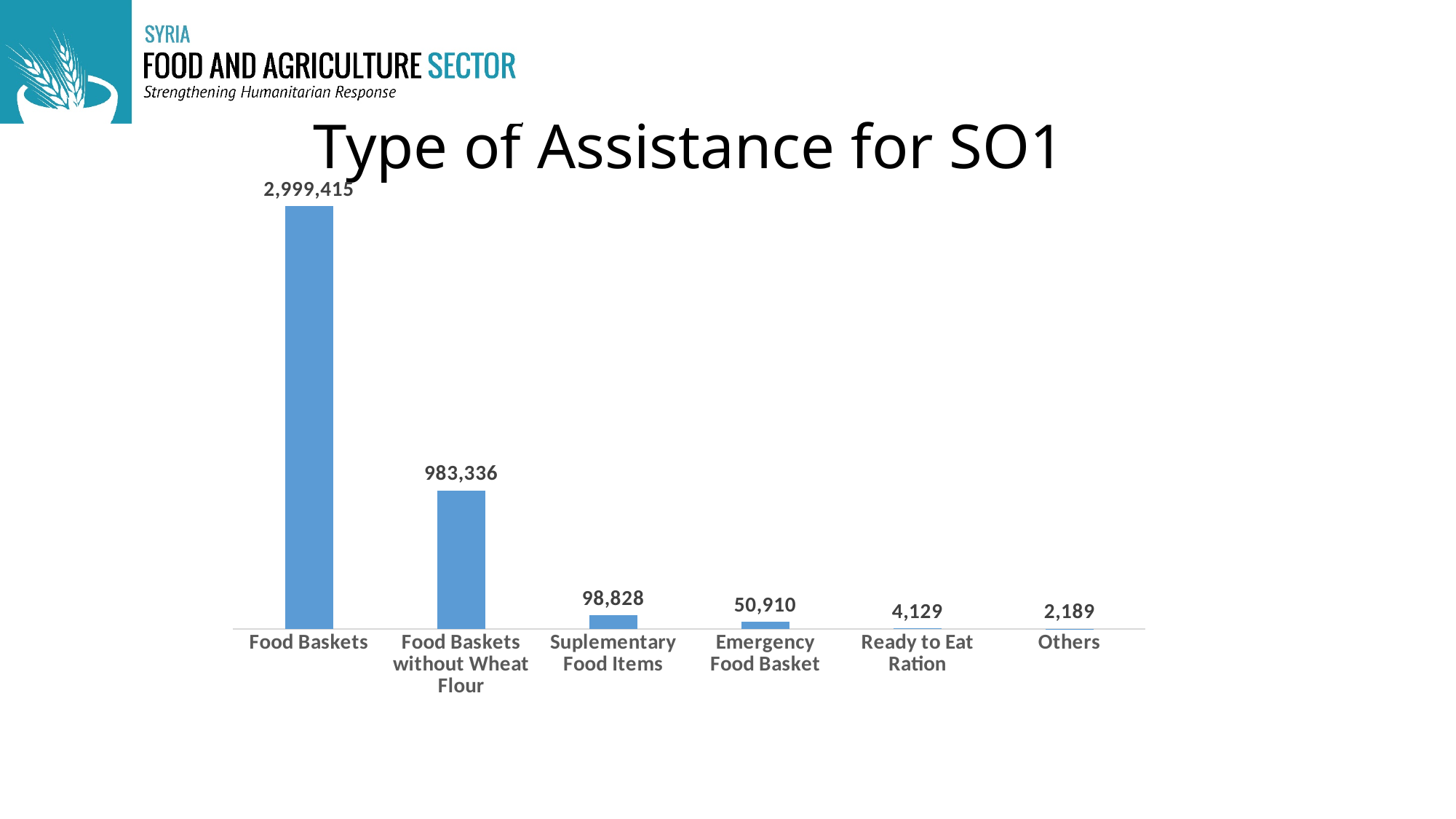
Which is larger, the value for Suplementary Food Items or the value for Emergency Food Basket? Suplementary Food Items What is the value for Food Baskets without Wheat Flour? 983,336 What is the value for Suplementary Food Items? 98,828 What is the value for Others? 2,189 What is the value for Food Baskets? 2,999,415 Which category has the highest value? Food Baskets What is the difference between the values for Food Baskets and Food Baskets without Wheat Flour? 2,016,079 Which category has the lowest value? Others What is the value for Emergency Food Basket? 50,910 How many categories are shown in the chart? 6 What kind of chart is shown on the slide? Bar chart What is the value for Ready to Eat Ration? 4,129